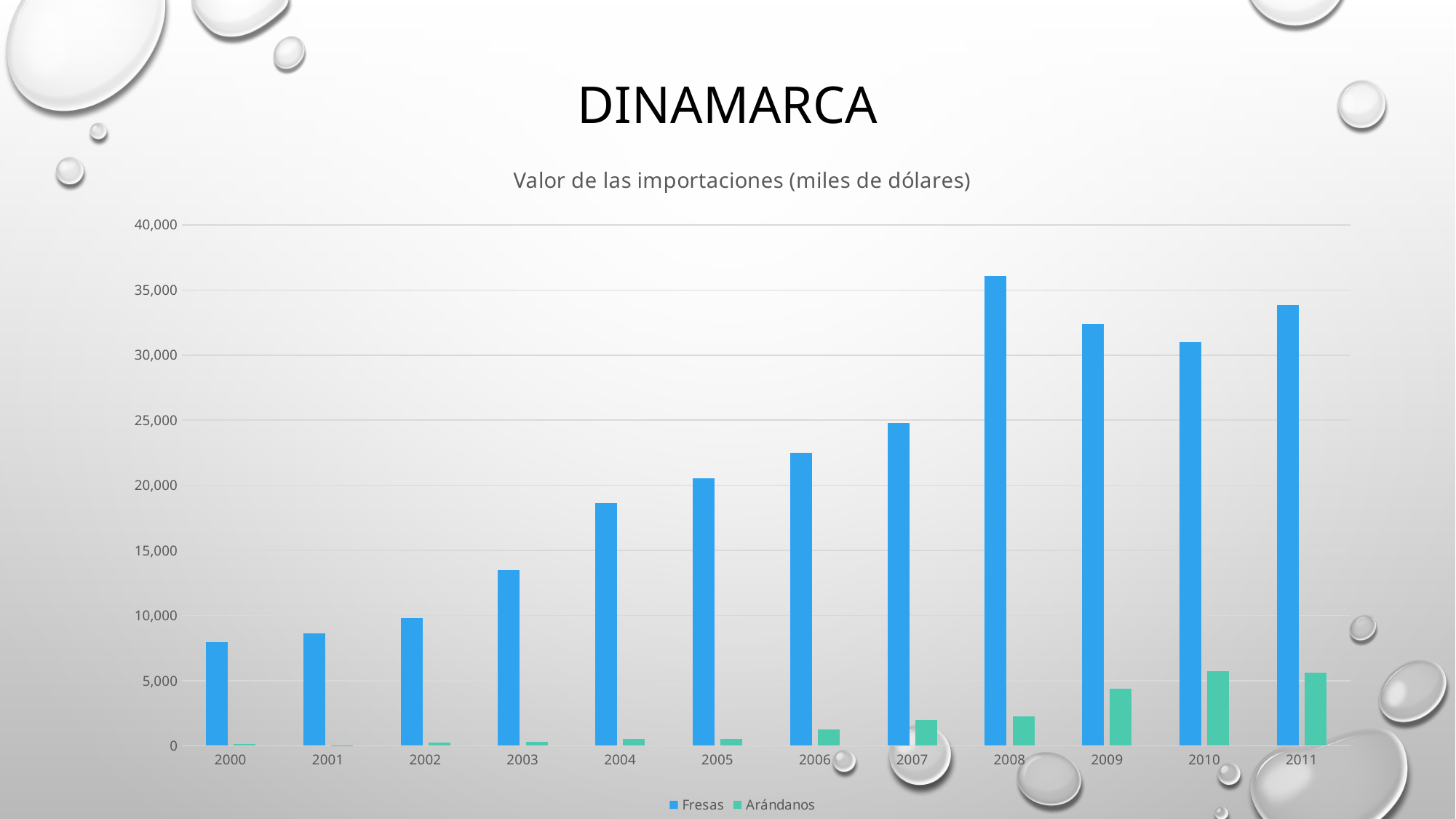
Is the value for Fresas in 2008 greater or less than 35,000? greater Is the value for Arándanos in 2009 greater or less than 5,000? less What kind of chart is shown on the slide? bar chart Is the value for Fresas in 2006 greater or less than 20,000? greater In which year is the value for Fresas highest? 2008 In which year is the value for Fresas lowest? 2000 What is the title of the chart? Valor de las importaciones (miles de dólares) Which is larger, the value for Fresas in 2009 or in 2010? 2009 How many series does the legend list? 2 Do the values for Fresas rise or fall from 2000 to 2008? rise How many years are shown on the x axis? 12